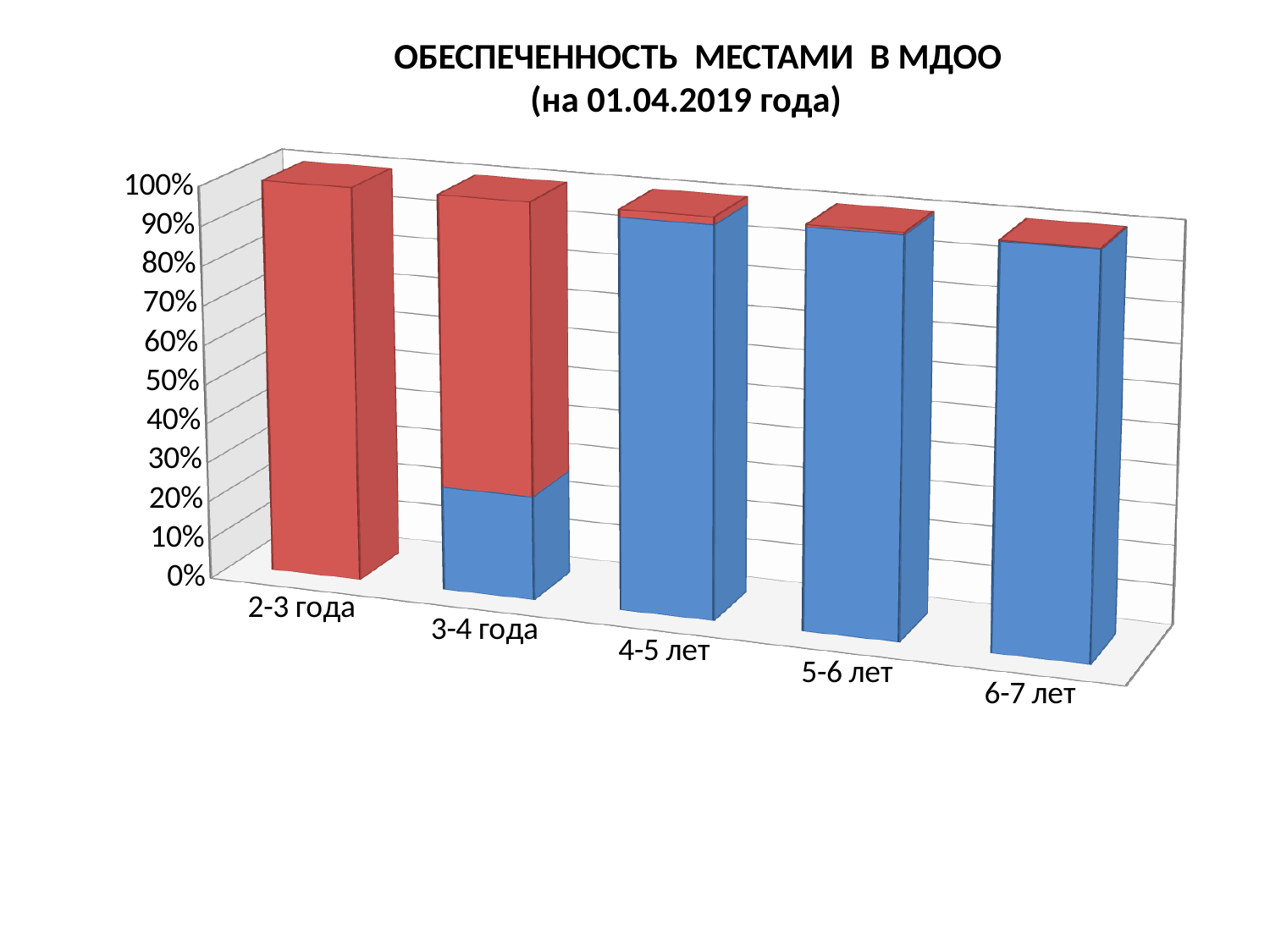
What kind of chart is shown on the slide? Stacked bar chart Is the red segment for 6-7 лет greater or less than 30%? less What is the title of the chart? ОБЕСПЕЧЕННОСТЬ МЕСТАМИ В МДОО (на 01.04.2019 года) How many age-group categories are shown on the x axis? 5 Which has the larger blue segment, 3-4 года or 5-6 лет? 5-6 лет Is the blue segment for 4-5 лет greater or less than 80%? greater Which category has the largest red segment? 2-3 года How many different colours of segments are used in the bars? 2 Is the blue segment for 3-4 года greater or less than 30%? less Does the blue segment rise or fall from 2-3 года to 4-5 лет? rise What is the total height of the stacked bar for 2-3 года? 100%